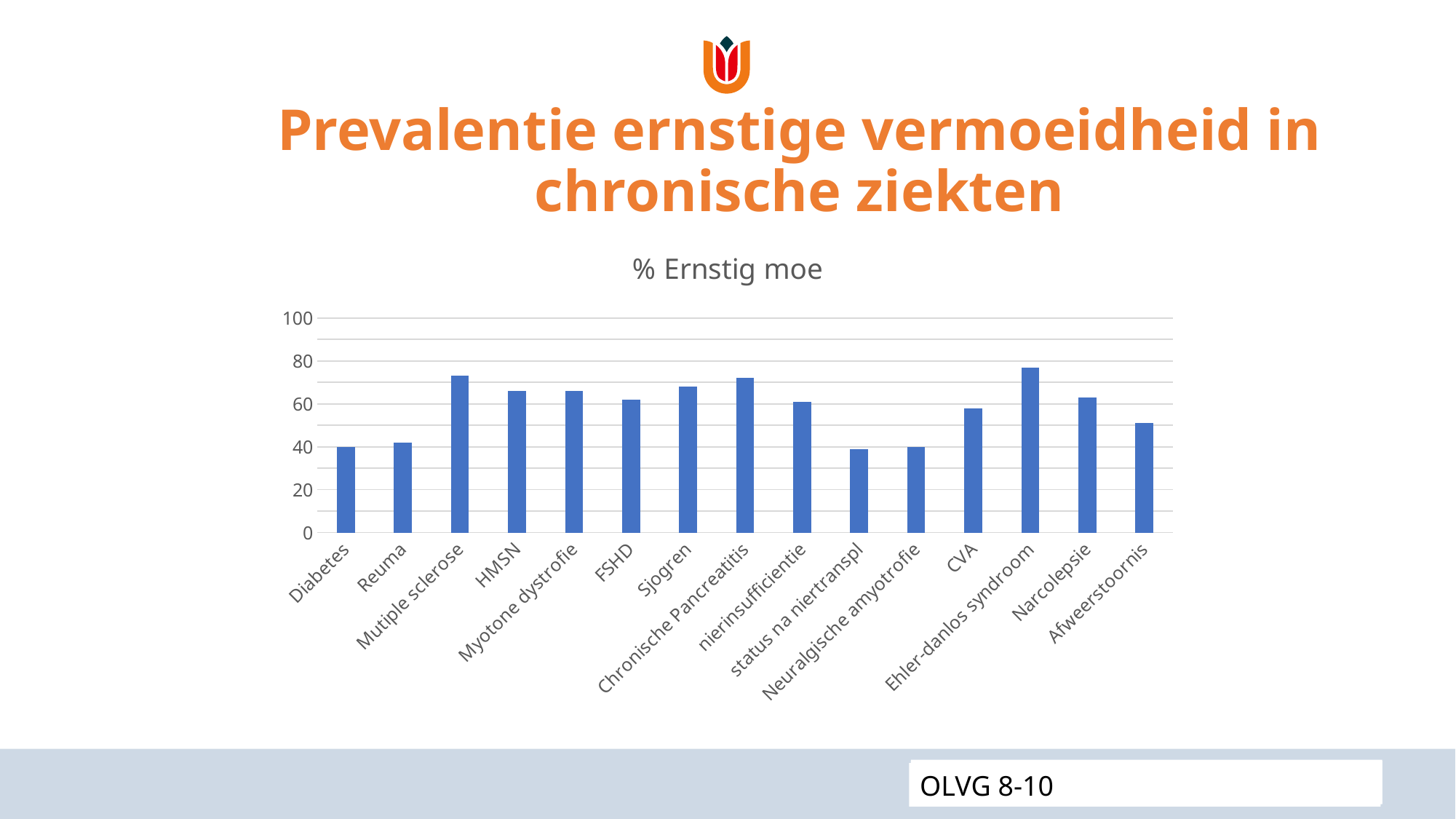
Which has a higher value, CVA or Reuma? CVA What is the title of the chart? % Ernstig moe Is the value for Mutiple sclerose greater or less than 60? greater Which has a higher value, Sjogren or Afweerstoornis? Sjogren Which has a higher value, Mutiple sclerose or Diabetes? Mutiple sclerose Is the value for Diabetes greater or less than 60? less What kind of chart is shown on the slide? bar chart Is the value for Ehler-danlos syndroom greater or less than 60? greater Which category has the highest value in the chart? Ehler-danlos syndroom How many categories (diseases) are plotted on the x axis of the chart? 15